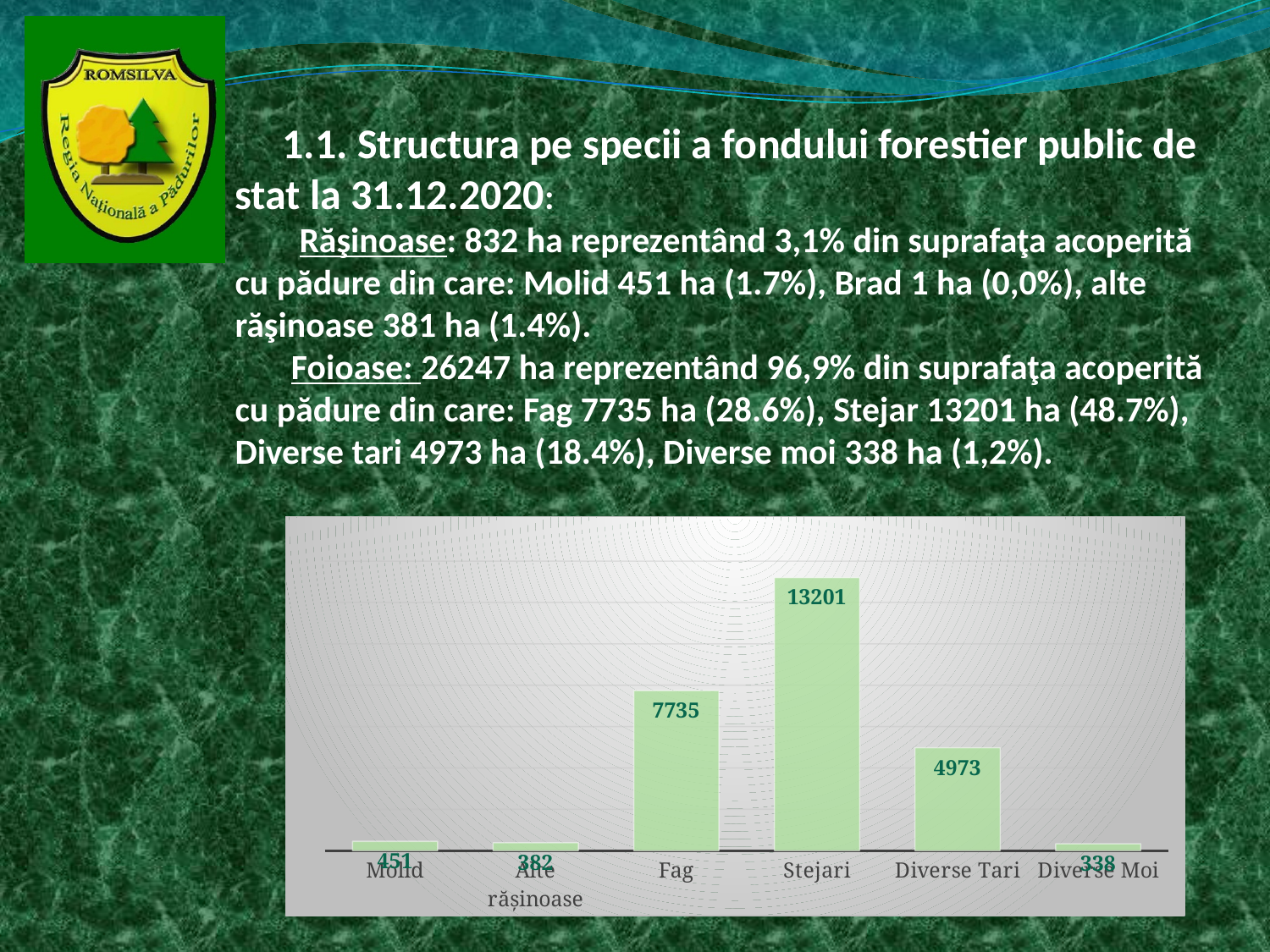
What value is shown for Fag in the bar chart? 7735 What value is shown for Molid in the bar chart? 451 What value is shown for Stejari in the bar chart? 13201 What is the difference between the values for Fag and Diverse Tari in the bar chart? 2762 What is the difference between the values for Stejari and Fag in the bar chart? 5466 What type of chart is shown on the slide? Bar chart Which category has the highest value in the bar chart? Stejari How many categories are shown in the bar chart? 6 Which category has the lowest value in the bar chart? Diverse Moi Which is larger in the bar chart, the value for Molid or the value for Alte rășinoase? Molid What value is shown for Diverse Tari in the bar chart? 4973 What value is shown for Diverse Moi in the bar chart? 338